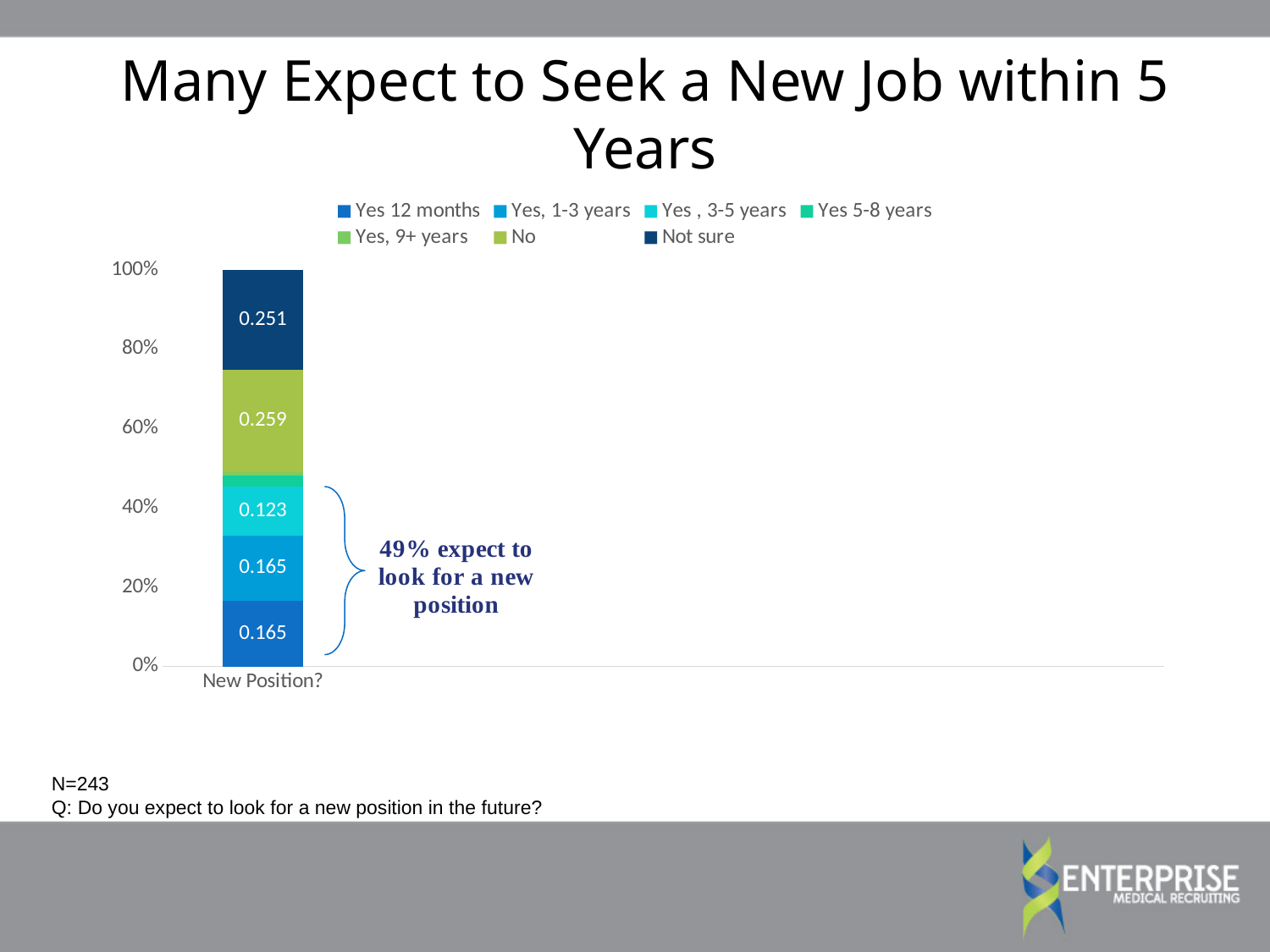
What is the value of the 'No' segment? 0.259 What is the value of the 'Not sure' segment? 0.251 What is the value of the 'Yes , 3-5 years' segment? 0.123 What kind of chart is shown on the slide? stacked bar chart How many series does the legend list? 7 What is the difference between the 'No' value and the 'Yes , 3-5 years' value? 0.136 How many categories are plotted on the x axis? 1 What is the value of the 'Yes 12 months' segment? 0.165 Which is larger, the 'No' segment or the 'Not sure' segment? No What is the label of the single category on the x axis? New Position? What is the value of the 'Yes, 1-3 years' segment? 0.165 According to the annotation next to the bar, what percentage expect to look for a new position? 49%